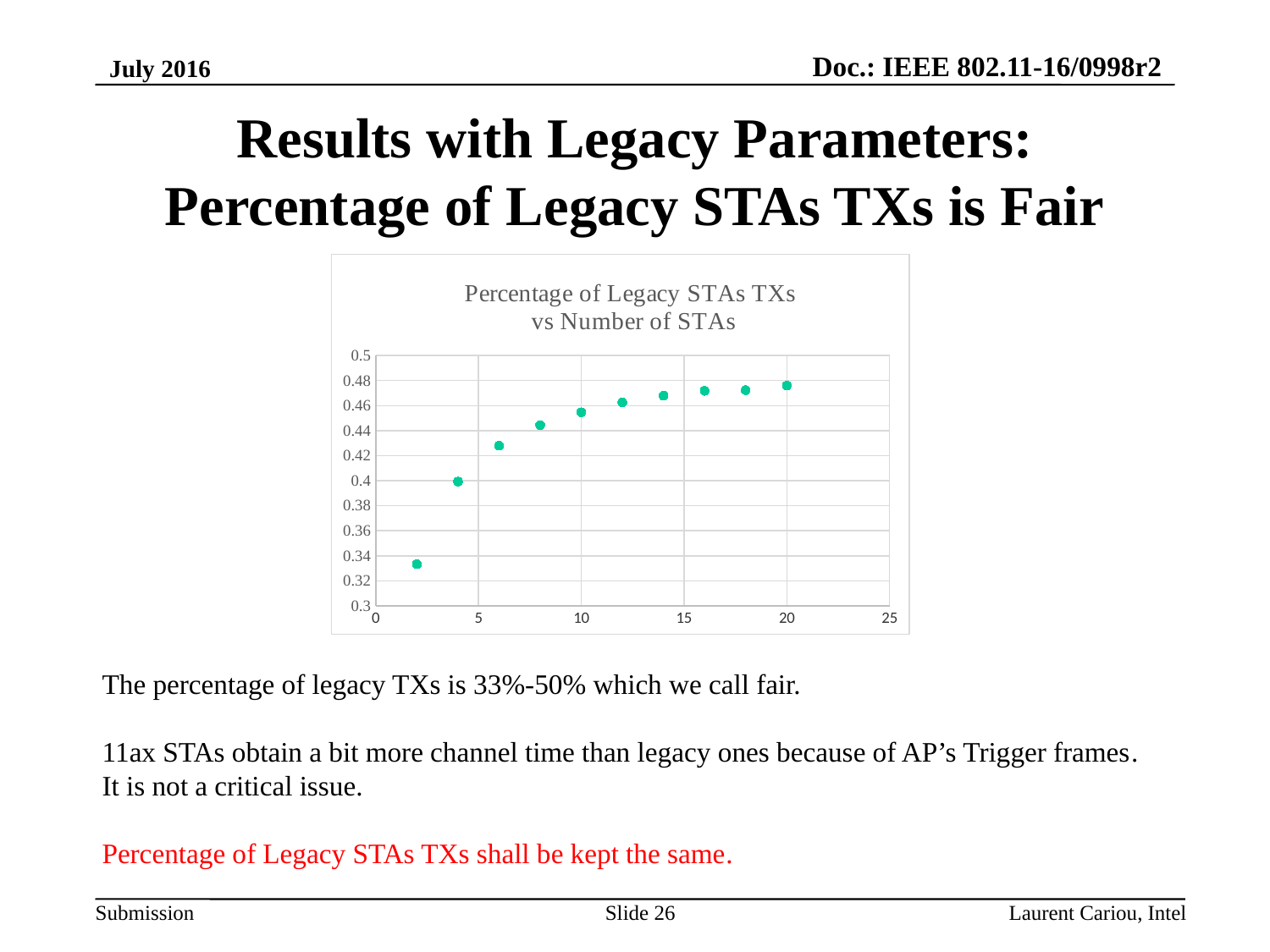
Which is larger, the value at 2 STAs or the value at 10 STAs? 10 STAs Is the value at 6 STAs greater or less than 0.42? greater What kind of chart is shown on the slide? scatter chart What is the maximum value shown on the y axis of the chart? 0.5 Is the value at 4 STAs greater or less than 0.38? greater Is the value at 20 STAs greater or less than 0.5? less At which number of STAs is the percentage of legacy STAs TXs lowest? 2 What is the title of the chart? Percentage of Legacy STAs TXs vs Number of STAs How many data points are plotted in the chart? 10 Do the plotted values rise or fall as the number of STAs increases along the x axis? rise